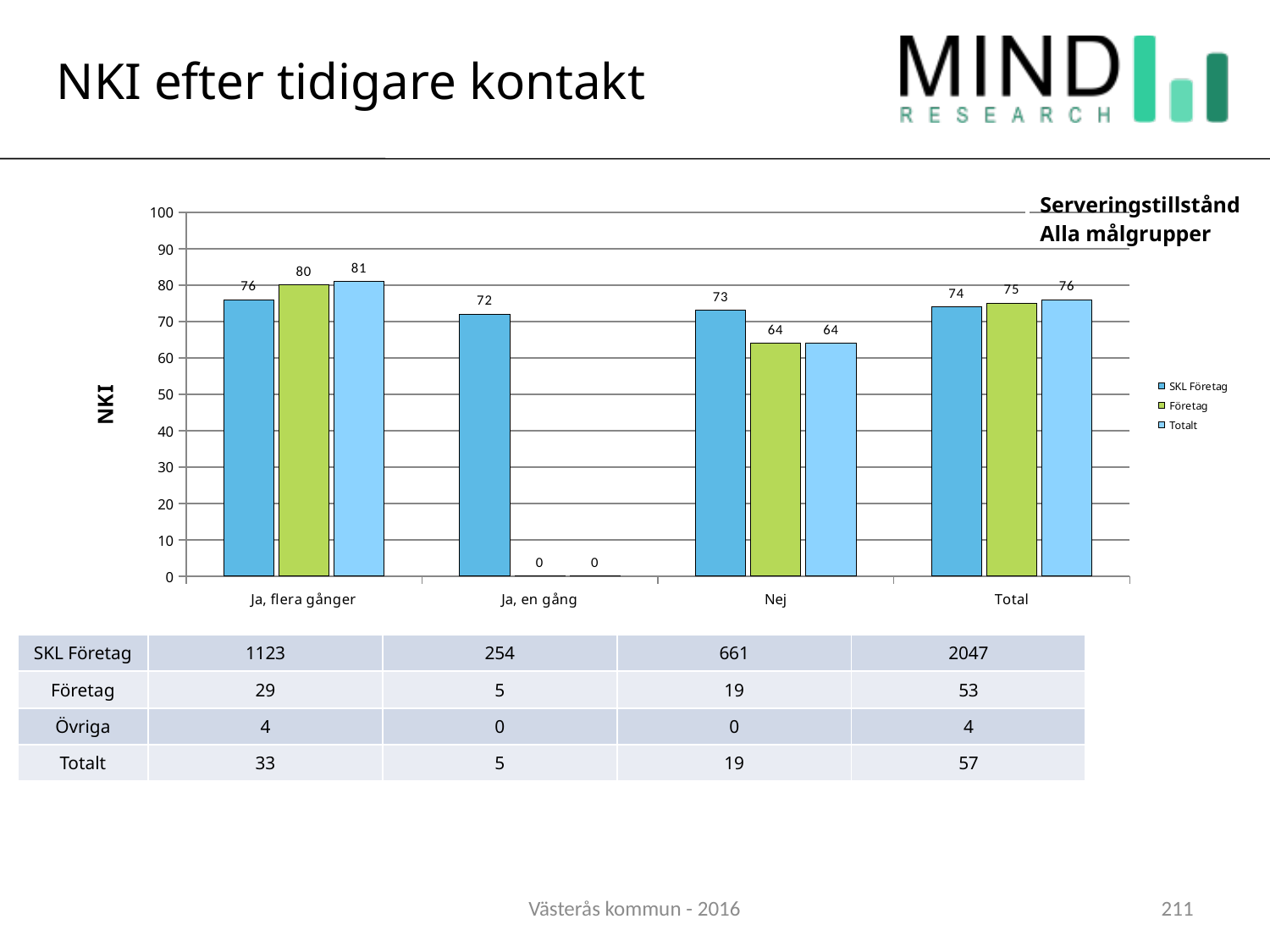
What is the difference between the Företag value for 'Ja, flera gånger' and the Företag value for 'Nej'? 16 Which category has the lowest Företag value? Ja, en gång What is the NKI value for Totalt in the 'Nej' category? 64 What is the NKI value for Företag in the 'Total' category? 75 What kind of chart is shown on the slide? Bar chart What is the NKI value for SKL Företag in the 'Ja, en gång' category? 72 How many series does the legend list? 3 Which category has the highest Totalt value? Ja, flera gånger How many categories are shown on the x axis? 4 What is the NKI value for SKL Företag in the 'Ja, flera gånger' category? 76 Which is larger: the SKL Företag value for 'Nej' or the SKL Företag value for 'Ja, flera gånger'? Ja, flera gånger What is the label of the y axis? NKI